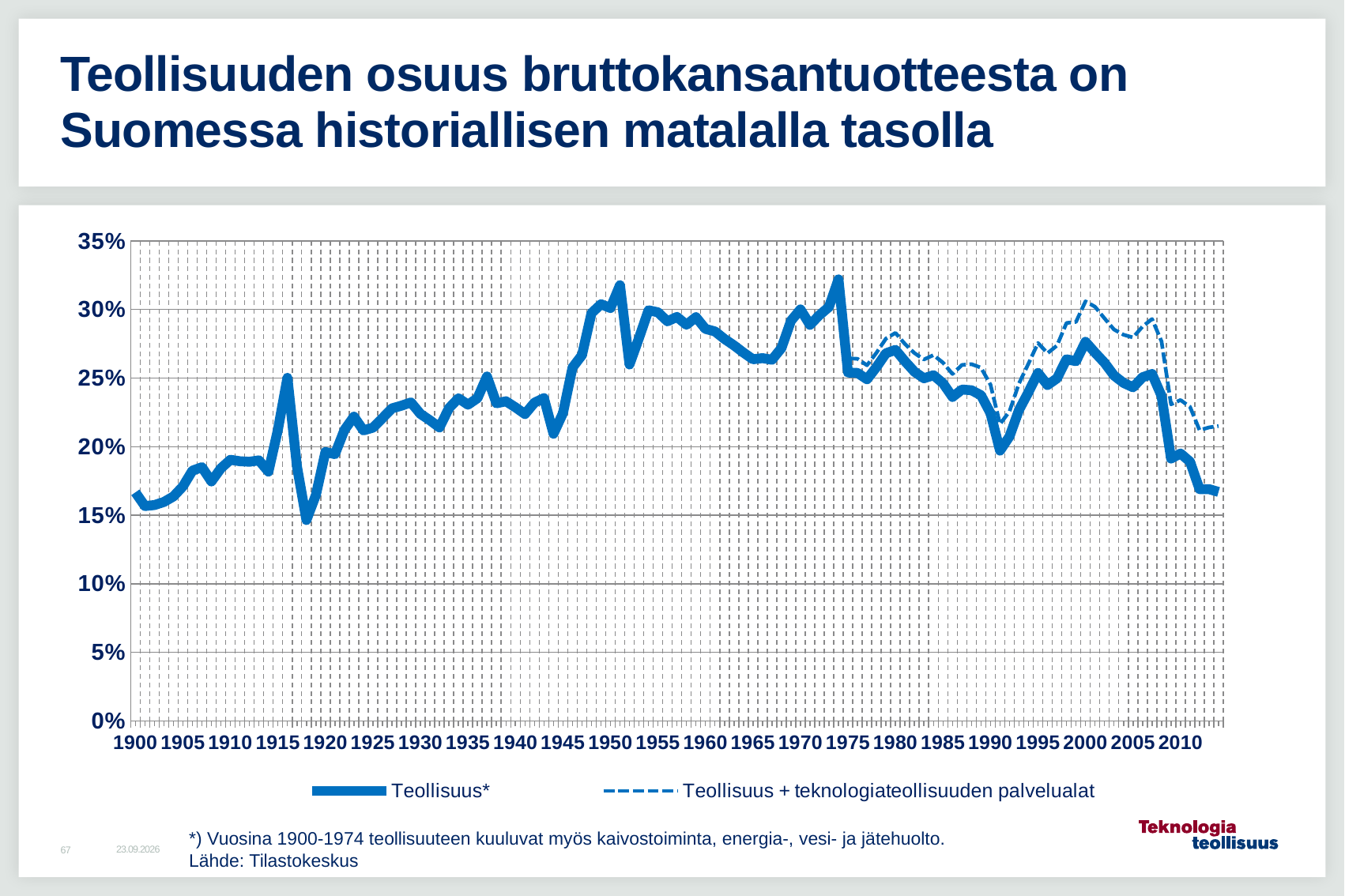
Is the value of Teollisuus + teknologiateollisuuden palvelualat in 2000 greater or less than 25%? greater How many series does the legend list? 2 Is the value of Teollisuus* around 1974 greater or less than 30%? greater Is the value of Teollisuus* around 1918 greater or less than 15%? less Which series is drawn with a dashed line? Teollisuus + teknologiateollisuuden palvelualat In 2010, which series has the higher value: Teollisuus* or Teollisuus + teknologiateollisuuden palvelualat? Teollisuus + teknologiateollisuuden palvelualat Around which year does the Teollisuus* series reach its lowest value? 1918 What kind of chart is shown on the slide? line chart What is the highest value shown on the vertical axis? 35% Does the Teollisuus* series rise or fall between 2005 and 2013? fall